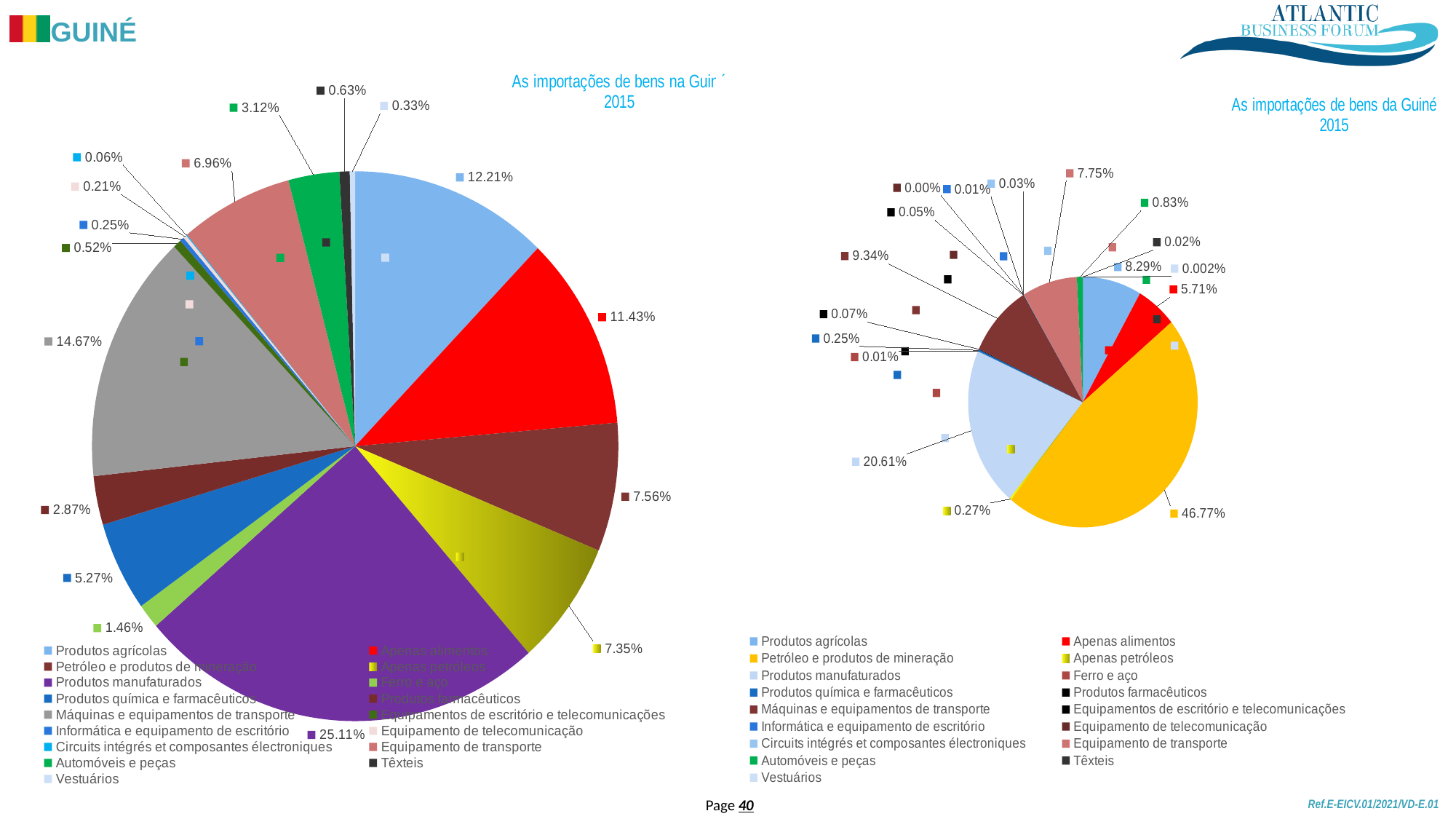
On the left pie chart, what is the share for Máquinas e equipamentos de transporte? 14.67% On the left pie chart, what is the share for Produtos manufaturados? 25.11% On the right pie chart titled 'As importações de bens da Guiné 2015', which category has the largest slice? Petróleo e produtos de mineração On the left pie chart, which is larger: Equipamento de transporte or Automóveis e peças? Equipamento de transporte On the left pie chart, what is the difference between the shares for Produtos agrícolas and Apenas alimentos? 0.78% On the right pie chart titled 'As importações de bens da Guiné 2015', what is the share for Petróleo e produtos de mineração? 46.77% How many categories does the legend of the right pie chart list? 17 On the left pie chart, which category has the largest slice? Produtos manufaturados On the right pie chart titled 'As importações de bens da Guiné 2015', which is larger: Apenas alimentos or Equipamento de transporte? Equipamento de transporte On the right pie chart titled 'As importações de bens da Guiné 2015', what is the difference between the shares for Máquinas e equipamentos de transporte and Produtos agrícolas? 1.05% On the right pie chart titled 'As importações de bens da Guiné 2015', what is the share for Produtos manufaturados? 20.61% What type of chart is used on the left side of the slide? Pie chart